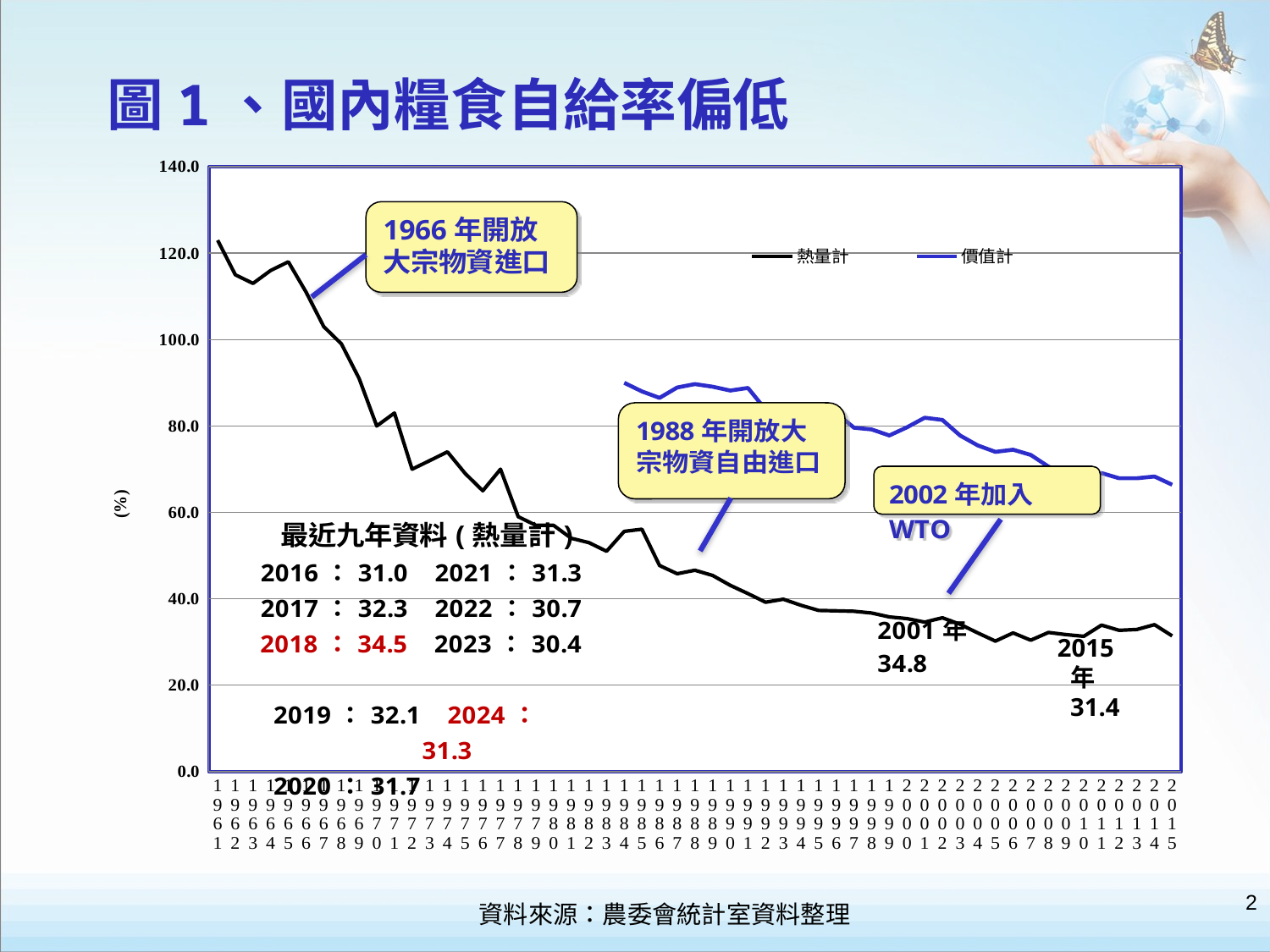
By how much did the labelled 熱量計 value fall from 2001年 (34.8) to 2015年 (31.4)? 3.4 Does the 熱量計 line generally rise or fall from 1961 to 2015? fall Is the 熱量計 value for 2015 greater or less than 40.0? less What is the title of the slide's chart? 圖1、國內糧食自給率偏低 What are the two series named in the chart's legend? 熱量計 and 價值計 Is the 熱量計 value for 1961 greater or less than 100.0? greater What is the 熱量計 value labelled for 2015年? 31.4 In 2015, which series is higher, 熱量計 or 價值計? 價值計 How many series does the chart's legend list? 2 What is the 熱量計 value labelled for 2001年? 34.8 Is the 價值計 value for 2015 greater or less than 60.0? greater What kind of chart is shown on the slide? line chart